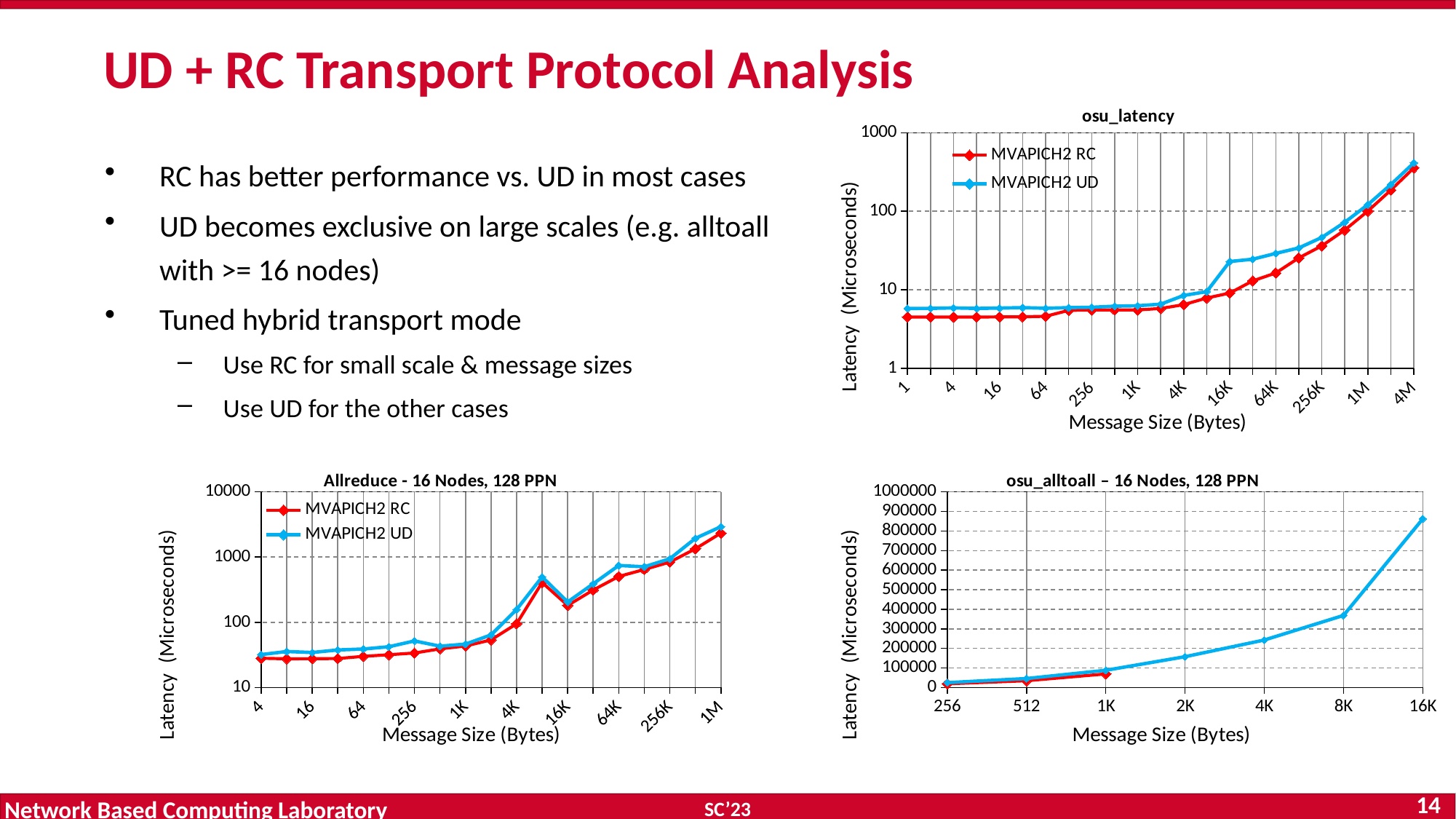
What kind of chart is the osu_latency chart? line chart In the Allreduce - 16 Nodes, 128 PPN chart, is the MVAPICH2 UD latency at message size 1M greater or less than 1000? greater In the osu_latency chart, is the MVAPICH2 UD latency at message size 16K greater or less than 10? greater In the osu_latency chart, which series is listed first in the legend? MVAPICH2 RC How many message sizes are labeled on the x axis of the osu_alltoall – 16 Nodes, 128 PPN chart? 7 In the osu_alltoall – 16 Nodes, 128 PPN chart, is the MVAPICH2 UD latency at message size 8K greater or less than 400000? less How many series does the legend of the Allreduce - 16 Nodes, 128 PPN chart list? 2 In the osu_latency chart, at message size 16K, which series has the higher latency, MVAPICH2 RC or MVAPICH2 UD? MVAPICH2 UD In the osu_alltoall – 16 Nodes, 128 PPN chart, does the MVAPICH2 UD latency rise or fall as message size increases? rise In the osu_alltoall – 16 Nodes, 128 PPN chart, at which message size does MVAPICH2 UD reach its highest latency? 16K